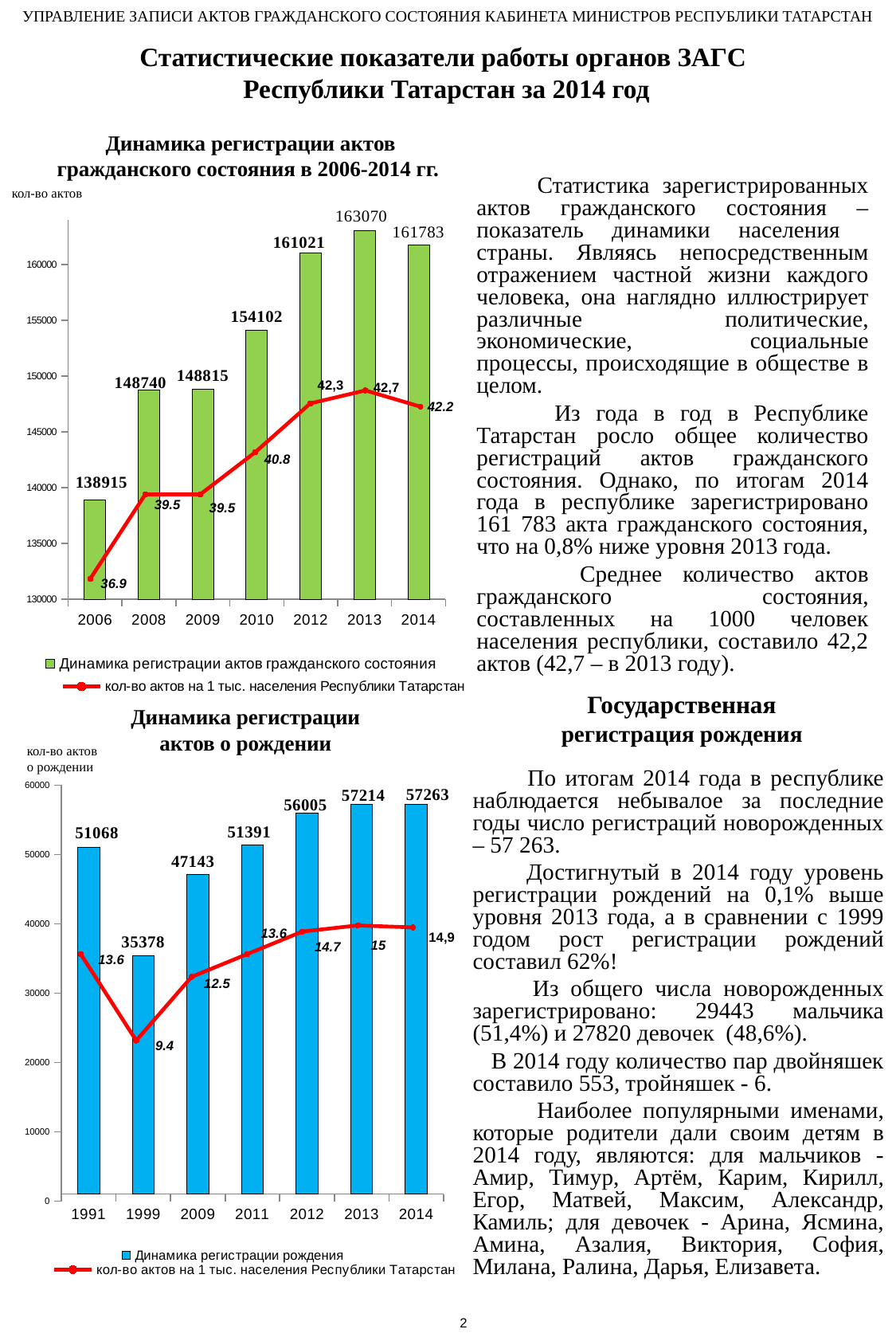
In the chart 'Динамика регистрации актов о рождении', what is the number of birth registrations in 1999? 35378 In the chart 'Динамика регистрации актов гражданского состояния в 2006-2014 гг.', how many series does the legend list? 2 In the chart 'Динамика регистрации актов о рождении', how many years are shown on the x axis? 7 In the chart 'Динамика регистрации актов о рождении', which year has the lowest bar? 1999 In the chart 'Динамика регистрации актов гражданского состояния в 2006-2014 гг.', which year has the highest bar? 2013 In the chart 'Динамика регистрации актов о рождении', what is the value of the line (кол-во актов на 1 тыс. населения) for 2013? 15 In the chart 'Динамика регистрации актов гражданского состояния в 2006-2014 гг.', what is the number of acts registered in 2010? 154102 In the chart 'Динамика регистрации актов о рождении', which is larger: the bar for 1991 or the bar for 2009? 1991 In the chart 'Динамика регистрации актов гражданского состояния в 2006-2014 гг.', what is the value of the line (кол-во актов на 1 тыс. населения) for 2006? 36.9 In the chart 'Динамика регистрации актов гражданского состояния в 2006-2014 гг.', which year has the lowest bar? 2006 In the chart 'Динамика регистрации актов о рождении', what is the difference between the 2014 and 2013 bar values? 49 In the chart 'Динамика регистрации актов гражданского состояния в 2006-2014 гг.', what is the difference between the 2013 and 2014 bar values? 1287